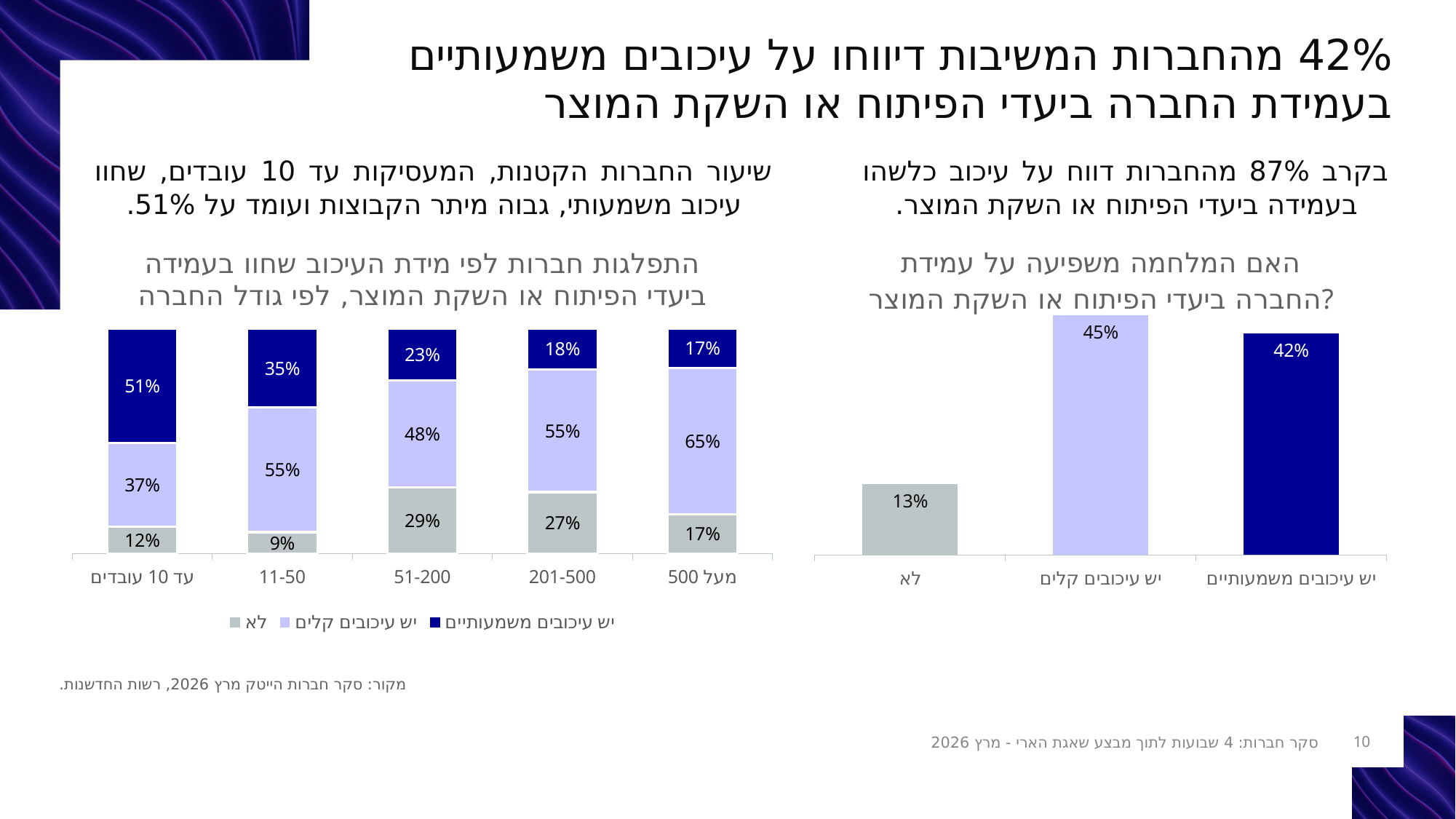
In the right-hand chart, how many categories are shown? 3 How many series does the legend of the left-hand chart list? 3 In the left-hand chart, what is the "לא" value for "51-200"? 29% In the right-hand chart, which category has the lowest value? לא In the left-hand chart, what is the difference between the "יש עיכובים קלים" values for "מעל 500" and "עד 10 עובדים"? 28% In the left-hand chart, which company-size category has the highest "יש עיכובים קלים" value? מעל 500 In the right-hand chart, what is the difference between "יש עיכובים קלים" and "יש עיכובים משמעותיים"? 3% In the left-hand chart, which company-size category has the lowest "לא" value? 11-50 In the right-hand chart ("האם המלחמה משפיעה על עמידת החברה ביעדי הפיתוח או השקת המוצר?"), what is the value for "יש עיכובים קלים"? 45% What kind of chart is the left-hand chart ("התפלגות חברות לפי מידת העיכוב...")? Stacked bar chart In the left-hand chart, what is the "יש עיכובים משמעותיים" value for "עד 10 עובדים"? 51% In the left-hand chart, is the "יש עיכובים משמעותיים" value larger for "11-50" or for "201-500"? 11-50